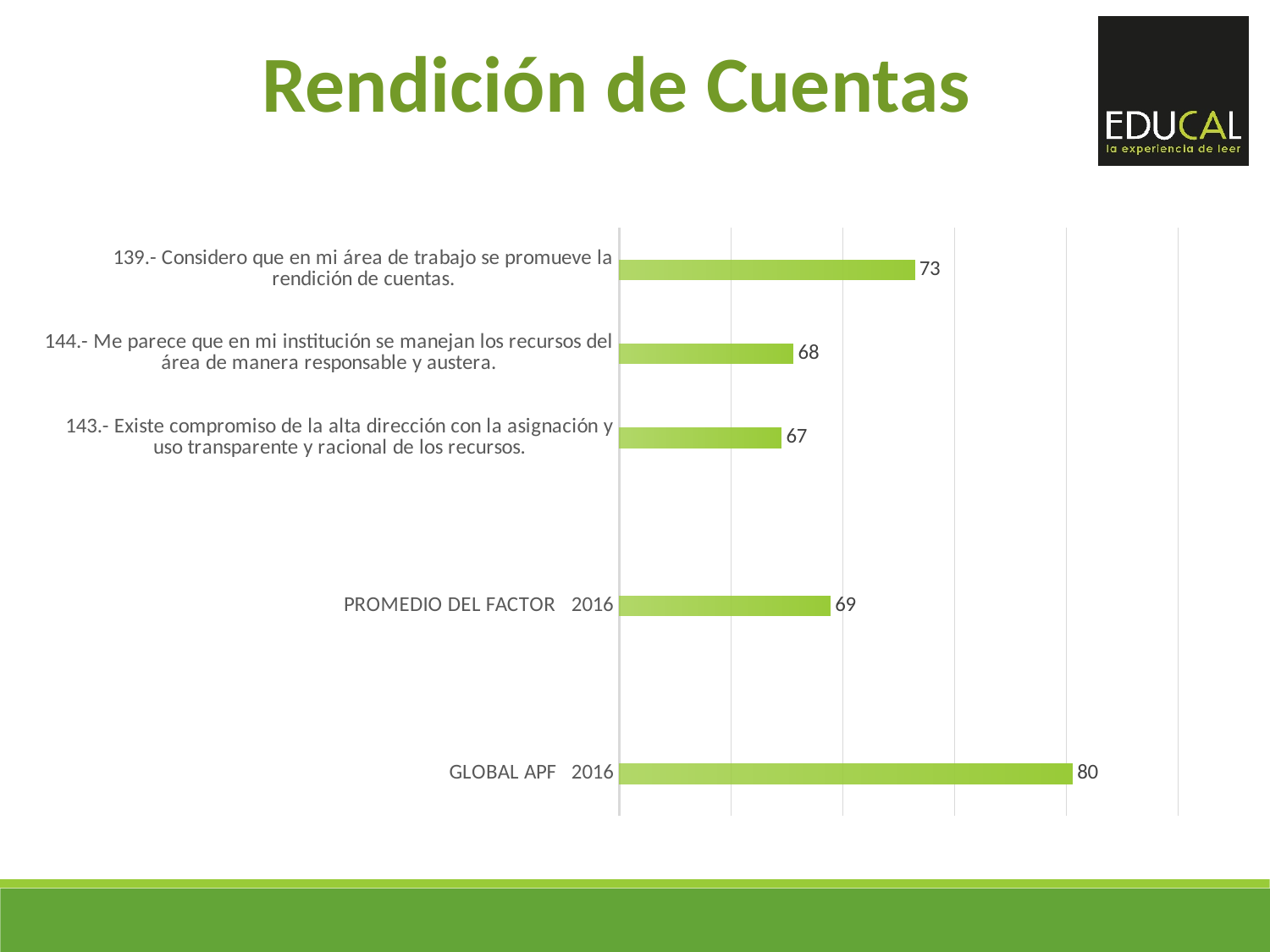
What is the difference between the value for GLOBAL APF 2016 and PROMEDIO DEL FACTOR 2016? 11 What is the title of the slide containing the chart? Rendición de Cuentas Which is larger, the value for item 139 or the value for item 144? Item 139 What is the value for PROMEDIO DEL FACTOR 2016? 69 What is the value for item 143 (Existe compromiso de la alta dirección con la asignación y uso transparente y racional de los recursos)? 67 What kind of chart is shown on the slide? Bar chart What is the value for item 144 (Me parece que en mi institución se manejan los recursos del área de manera responsable y austera)? 68 What is the value for item 139 (Considero que en mi área de trabajo se promueve la rendición de cuentas)? 73 Which category has the highest value? GLOBAL APF 2016 How many bars are plotted in the chart? 5 Which category has the lowest value? 143.- Existe compromiso de la alta dirección con la asignación y uso transparente y racional de los recursos. What is the value for GLOBAL APF 2016? 80